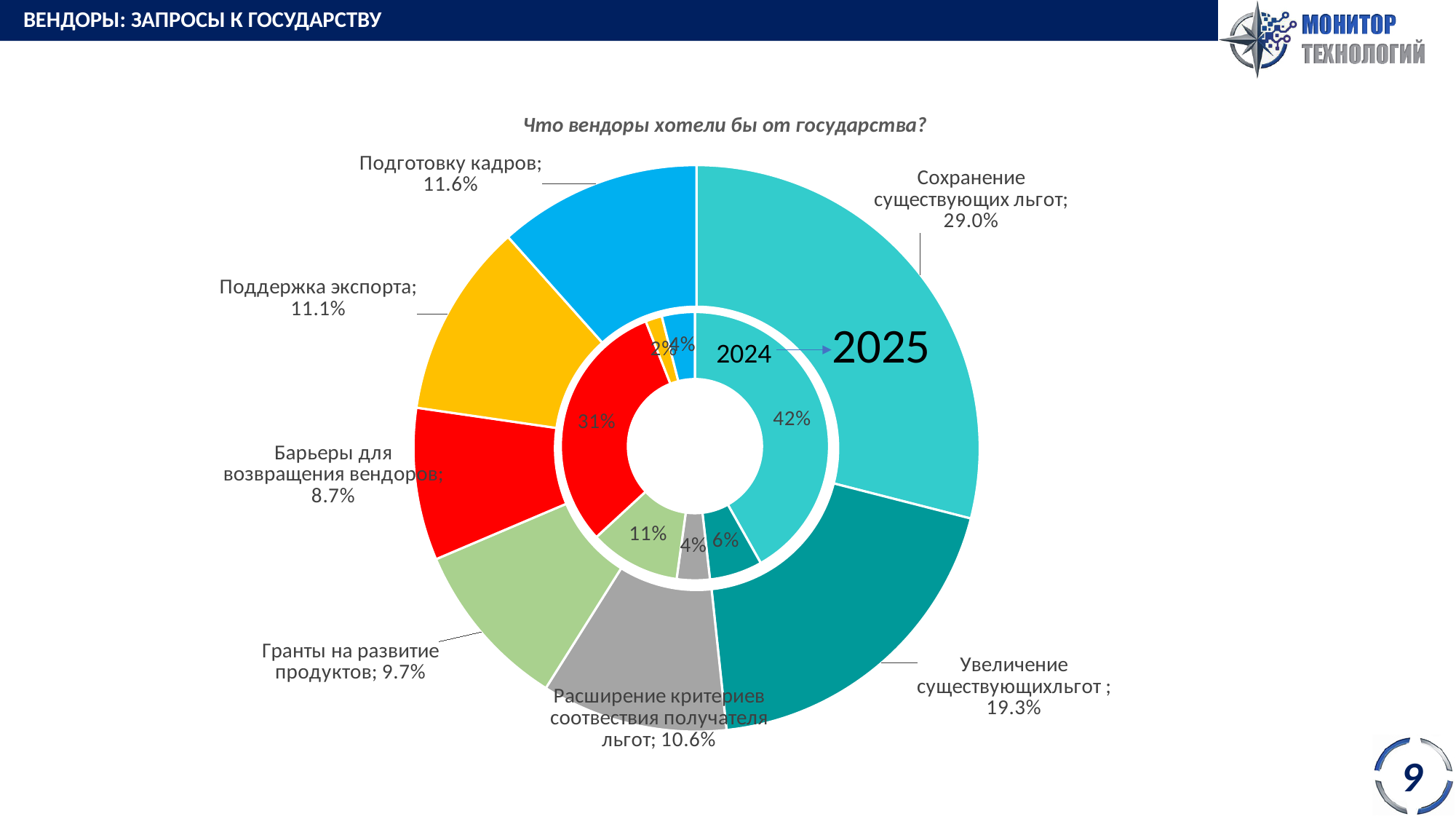
What is the difference between the 2025 shares of «Сохранение существующих льгот» and «Увеличение существующих льгот»? 9.7% What is the 2025 share for «Подготовку кадров»? 11.6% Which category has the smallest share in the outer (2025) ring? Барьеры для возвращения вендоров In 2025, which is larger: «Поддержка экспорта» or «Гранты на развитие продуктов»? Поддержка экспорта What type of chart is shown on the slide? Doughnut chart What is the 2025 share for «Расширение критериев соответствия получателя льгот»? 10.6% What is the title of the chart? Что вендоры хотели бы от государства? How many categories are shown in the outer (2025) ring? 7 What is the 2025 share for «Увеличение существующих льгот»? 19.3% Which category has the largest share in the outer (2025) ring? Сохранение существующих льгот What is the 2025 share for «Сохранение существующих льгот»? 29.0% What is the largest value shown in the inner (2024) ring? 42%